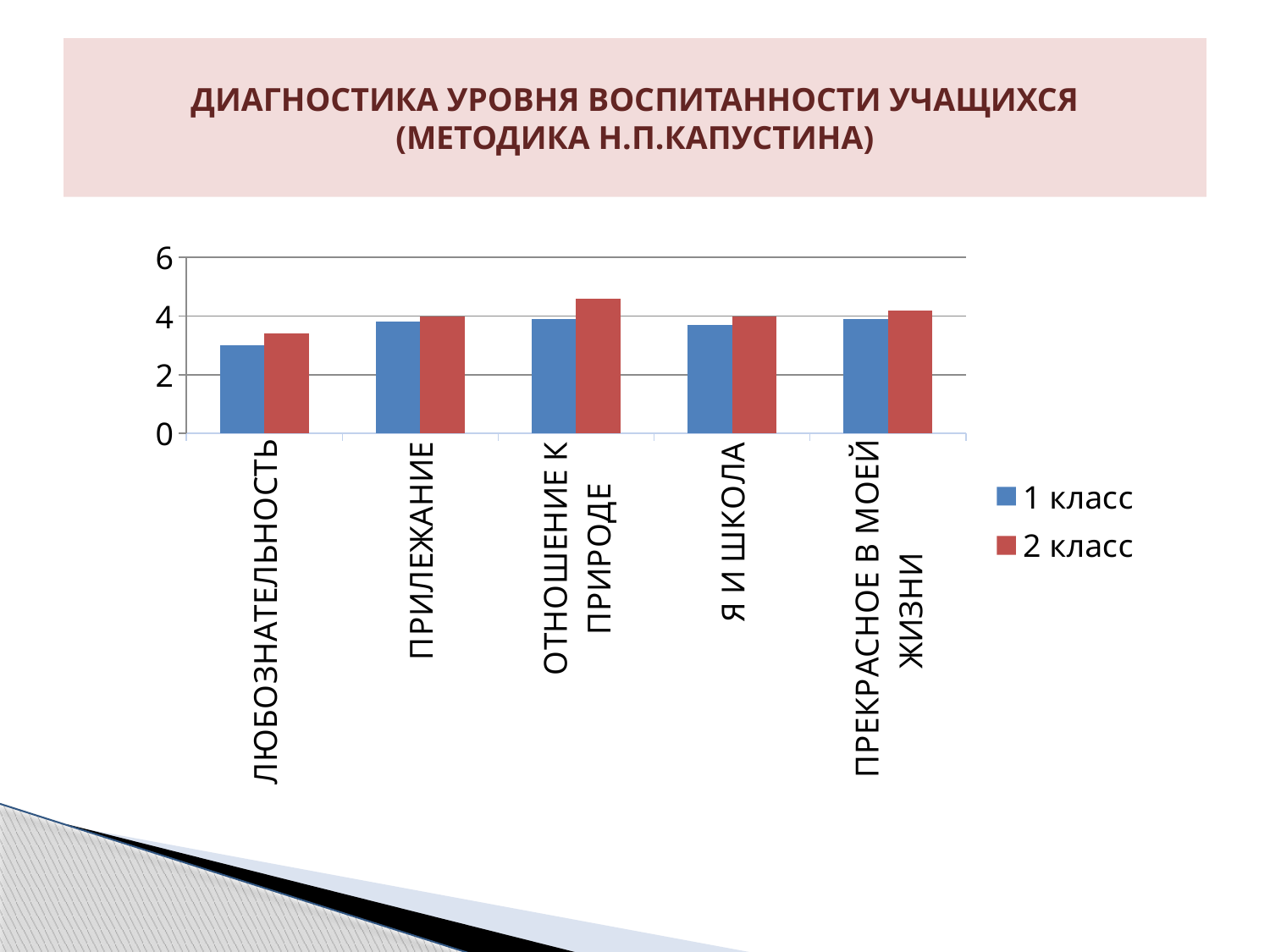
For the series 2 класс, which category has the highest value? ОТНОШЕНИЕ К ПРИРОДЕ For the series 2 класс, which category has the lowest value? ЛЮБОЗНАТЕЛЬНОСТЬ For ОТНОШЕНИЕ К ПРИРОДЕ, which series has the larger value, 1 класс or 2 класс? 2 класс What kind of chart is shown on the slide? bar chart Is the value for ЛЮБОЗНАТЕЛЬНОСТЬ in the series 1 класс greater or less than 4? less What are the two series named in the chart legend? 1 класс and 2 класс How many categories are shown on the x axis of the chart? 5 Is the value for ОТНОШЕНИЕ К ПРИРОДЕ in the series 2 класс greater or less than 4? greater How many series does the chart legend list? 2 For the series 1 класс, which category has the lowest value? ЛЮБОЗНАТЕЛЬНОСТЬ Is the value for ЛЮБОЗНАТЕЛЬНОСТЬ in the series 2 класс greater or less than 2? greater Which colour represents the series 1 класс in the chart? blue